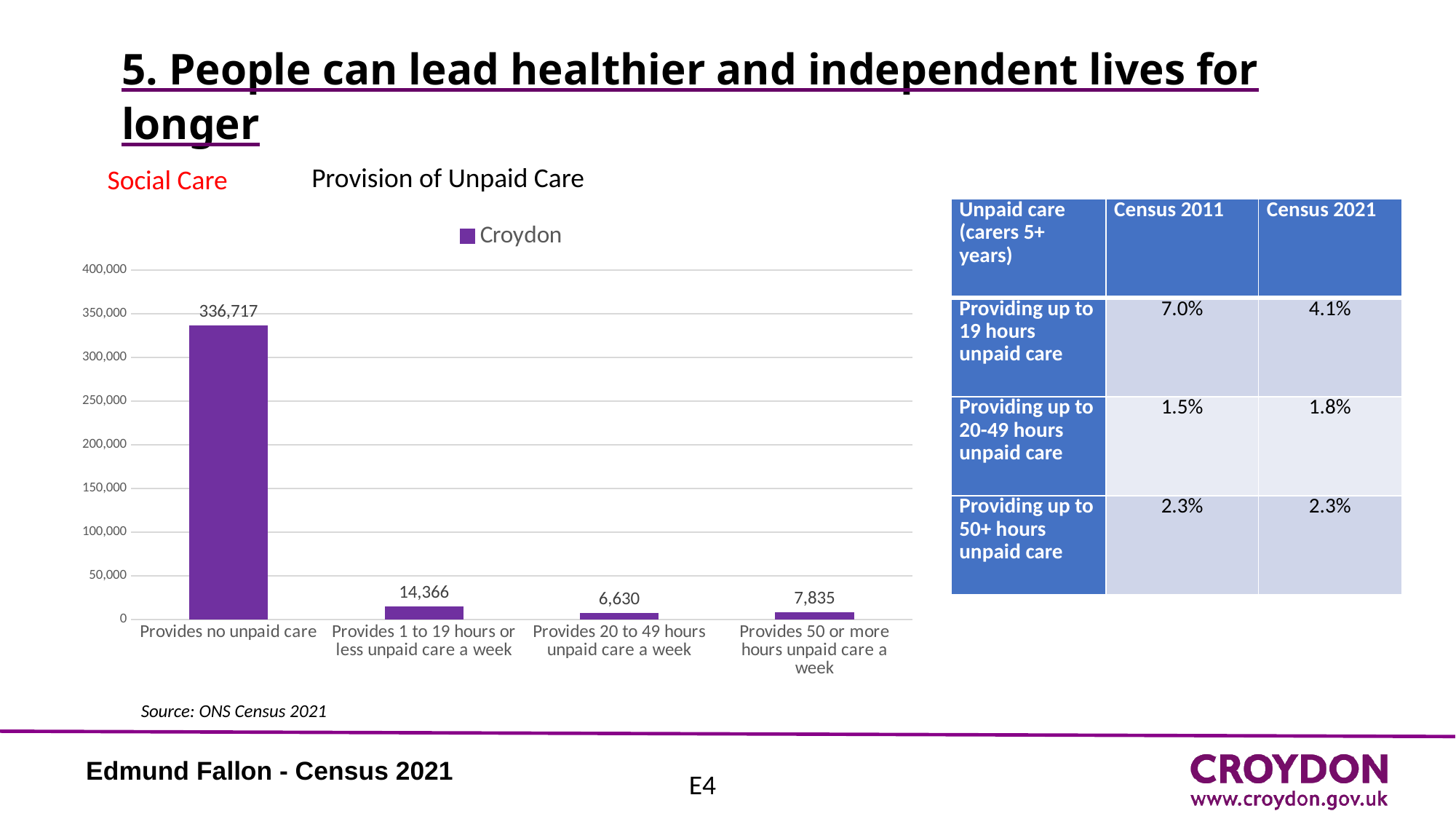
Which category has the lowest value in the chart? Provides 20 to 49 hours unpaid care a week Which is larger: the value for 'Provides 50 or more hours unpaid care a week' or 'Provides 20 to 49 hours unpaid care a week'? Provides 50 or more hours unpaid care a week What is the value for 'Provides 50 or more hours unpaid care a week'? 7,835 How many categories are shown on the x axis of the chart? 4 What is the value for 'Provides 20 to 49 hours unpaid care a week'? 6,630 Is the value for 'Provides no unpaid care' greater or less than 300,000? greater What is the difference between the values for 'Provides 1 to 19 hours or less unpaid care a week' and 'Provides 50 or more hours unpaid care a week'? 6,531 How many series does the chart legend list? 1 Which category has the highest value in the chart? Provides no unpaid care What is the value for 'Provides no unpaid care' in the Provision of Unpaid Care chart? 336,717 What is the value for 'Provides 1 to 19 hours or less unpaid care a week'? 14,366 What type of chart is shown on the slide? bar chart